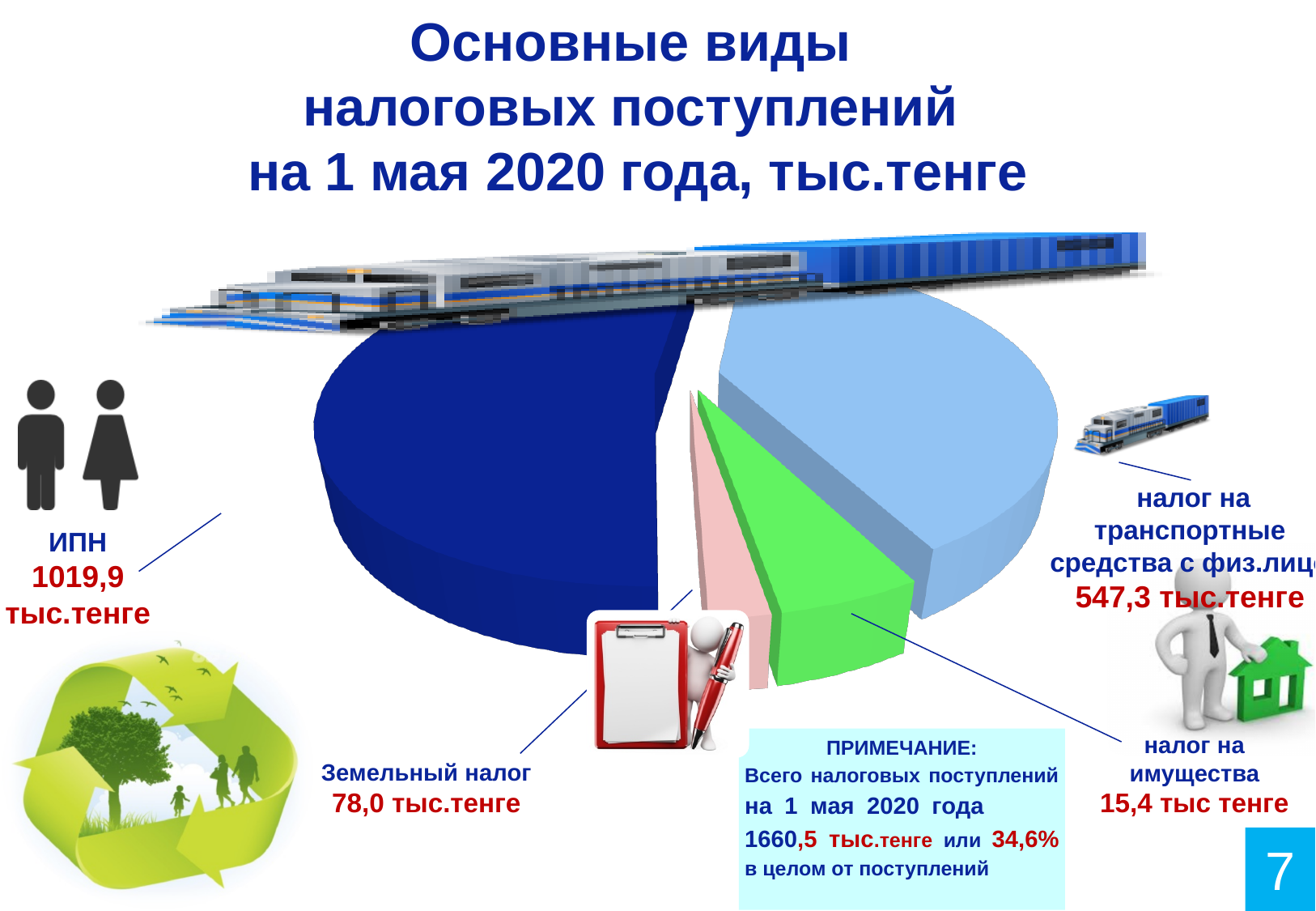
Which type of tax revenue has the highest value in the pie chart? ИПН What is the difference between the value for ИПН and the value for налог на транспортные средства с физ.лиц? 472,6 тыс.тенге What kind of chart is shown on the slide? pie chart What is the value shown for налог на имущества? 15,4 тыс тенге What is the title of the chart on the slide? Основные виды налоговых поступлений на 1 мая 2020 года, тыс.тенге According to the note on the slide, what is the total of tax revenues as of 1 May 2020? 1660,5 тыс.тенге What is the value shown for Земельный налог? 78,0 тыс.тенге How many slices does the pie chart have? 4 Which type of tax revenue has the lowest value in the pie chart? налог на имущества What is the value shown for ИПН? 1019,9 тыс.тенге Which is larger, Земельный налог or налог на имущества? Земельный налог What is the value shown for налог на транспортные средства с физ.лиц? 547,3 тыс.тенге